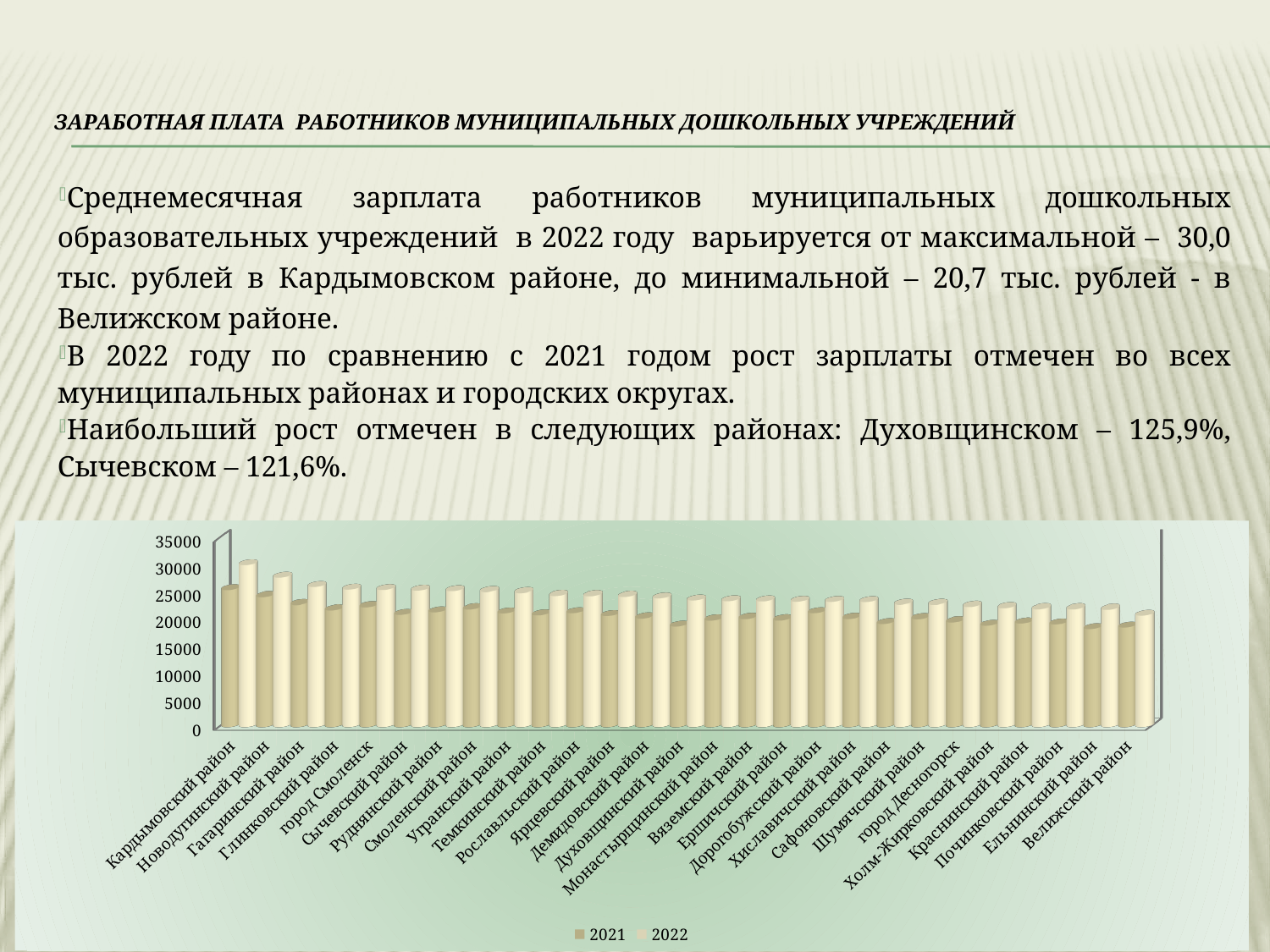
Is the 2021 value for Велижский район greater or less than 20000? less Which district has the lowest 2022 value in the chart? Велижский район Do the 2022 values generally rise or fall moving from left to right along the x axis? fall How many series does the chart legend list? 2 Which years are listed in the chart legend? 2021 and 2022 What kind of chart is shown on the slide? bar chart How many districts (categories) are shown on the x axis of the chart? 27 Is the 2022 value for Кардымовский район greater or less than 25000? greater Which category is listed first on the x axis of the chart? Кардымовский район Which district has the highest 2022 value in the chart? Кардымовский район Is the 2022 value for Велижский район greater or less than 25000? less Which is larger: the 2022 value for Кардымовский район or the 2022 value for Велижский район? Кардымовский район